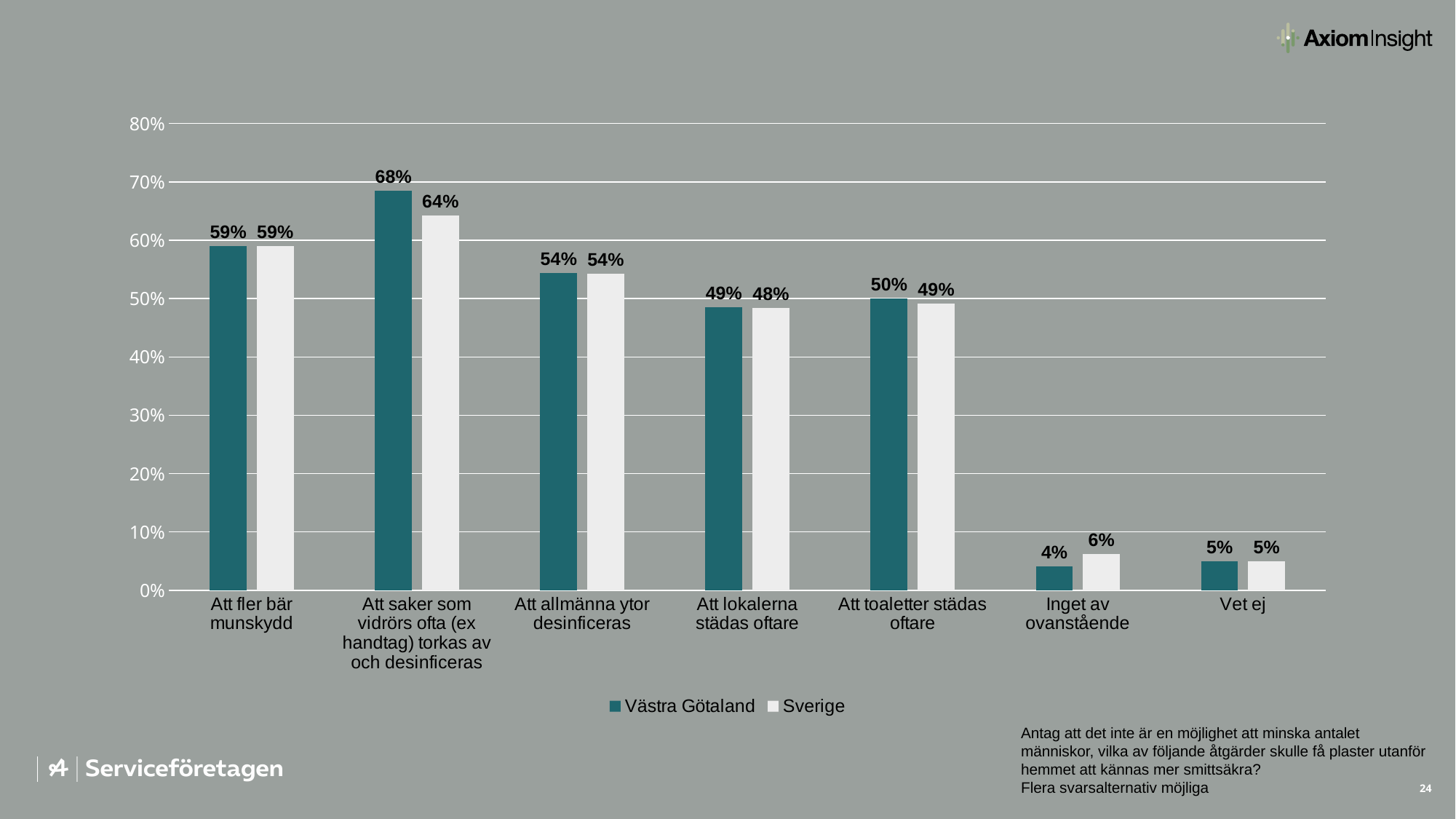
Which category has the lowest value for Västra Götaland? Inget av ovanstående Which is larger for 'Inget av ovanstående': Västra Götaland or Sverige? Sverige What is the value for Sverige for 'Att lokalerna städas oftare'? 48% Is the value for Västra Götaland for 'Att toaletter städas oftare' greater or less than 40%? greater What is the value for Västra Götaland for 'Att saker som vidrörs ofta (ex handtag) torkas av och desinficeras'? 68% Which category has the highest value for Västra Götaland? Att saker som vidrörs ofta (ex handtag) torkas av och desinficeras How many categories are shown on the x axis? 7 What is the difference between Västra Götaland and Sverige for 'Att saker som vidrörs ofta (ex handtag) torkas av och desinficeras'? 4% What is the value for Sverige for 'Inget av ovanstående'? 6% Which series is shown in dark teal according to the legend? Västra Götaland What kind of chart is shown on the slide? Bar chart How many series does the legend list? 2